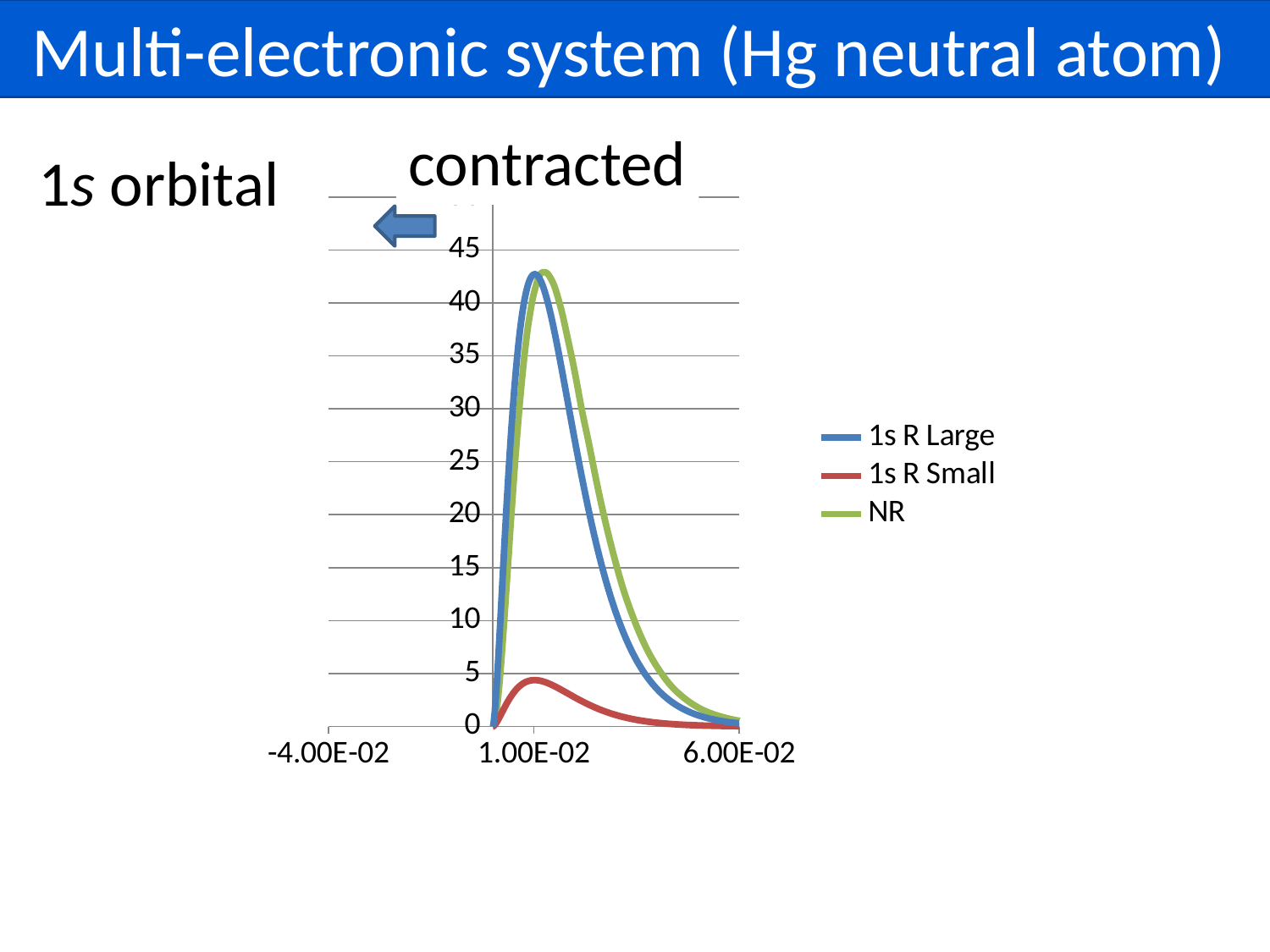
What is the highest labelled value on the chart's y axis? 45 What is the leftmost label on the chart's x axis? -4.00E-02 Which series is drawn in red in the chart? 1s R Small Which series has the lowest peak value in the chart? 1s R Small Which series reaches a higher peak, 1s R Small or NR? NR Is the peak value of the 1s R Large series greater or less than 40? greater Is the peak value of the NR series greater or less than 40? greater Which series reaches a higher peak, 1s R Large or 1s R Small? 1s R Large How many series does the chart's legend list? 3 Is the peak value of the 1s R Small series greater or less than 10? less What kind of chart is shown on the slide? line chart